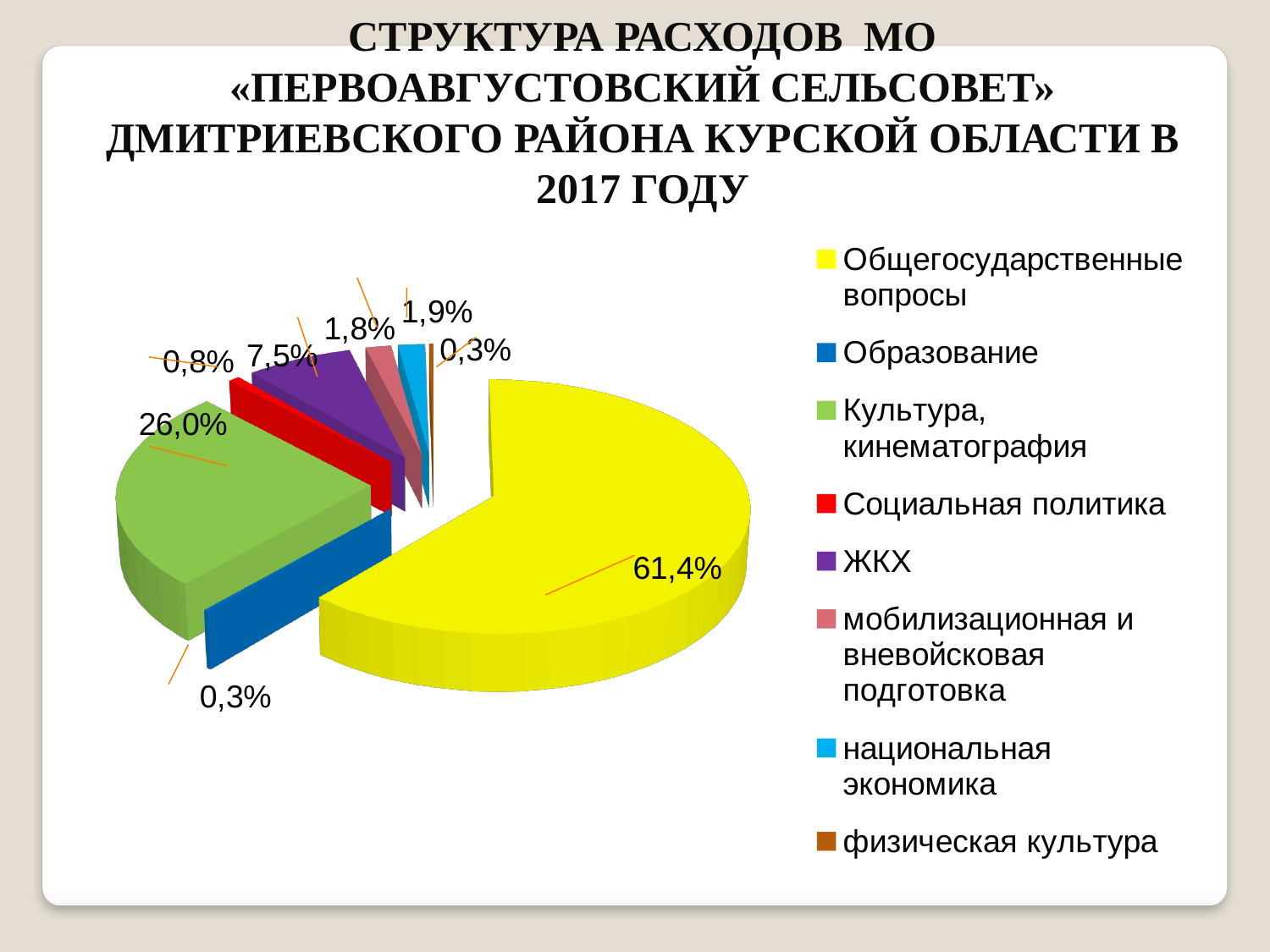
What share of expenditures is labelled for ЖКХ? 7,5% What share of expenditures is labelled for Общегосударственные вопросы? 61,4% What share of expenditures is labelled for Культура, кинематография? 26,0% What share of expenditures is labelled for Социальная политика? 0,8% What kind of chart is shown on the slide? pie chart What is the difference in percentage points between Общегосударственные вопросы and Культура, кинематография? 35,4 What share of expenditures is labelled for мобилизационная и вневойсковая подготовка? 1,8% What share of expenditures is labelled for национальная экономика? 1,9% How many categories does the legend list? 8 Which category has the largest share of expenditures? Общегосударственные вопросы Which is larger, the share for ЖКХ or the share for Социальная политика? ЖКХ What colour is the slice for Общегосударственные вопросы? yellow